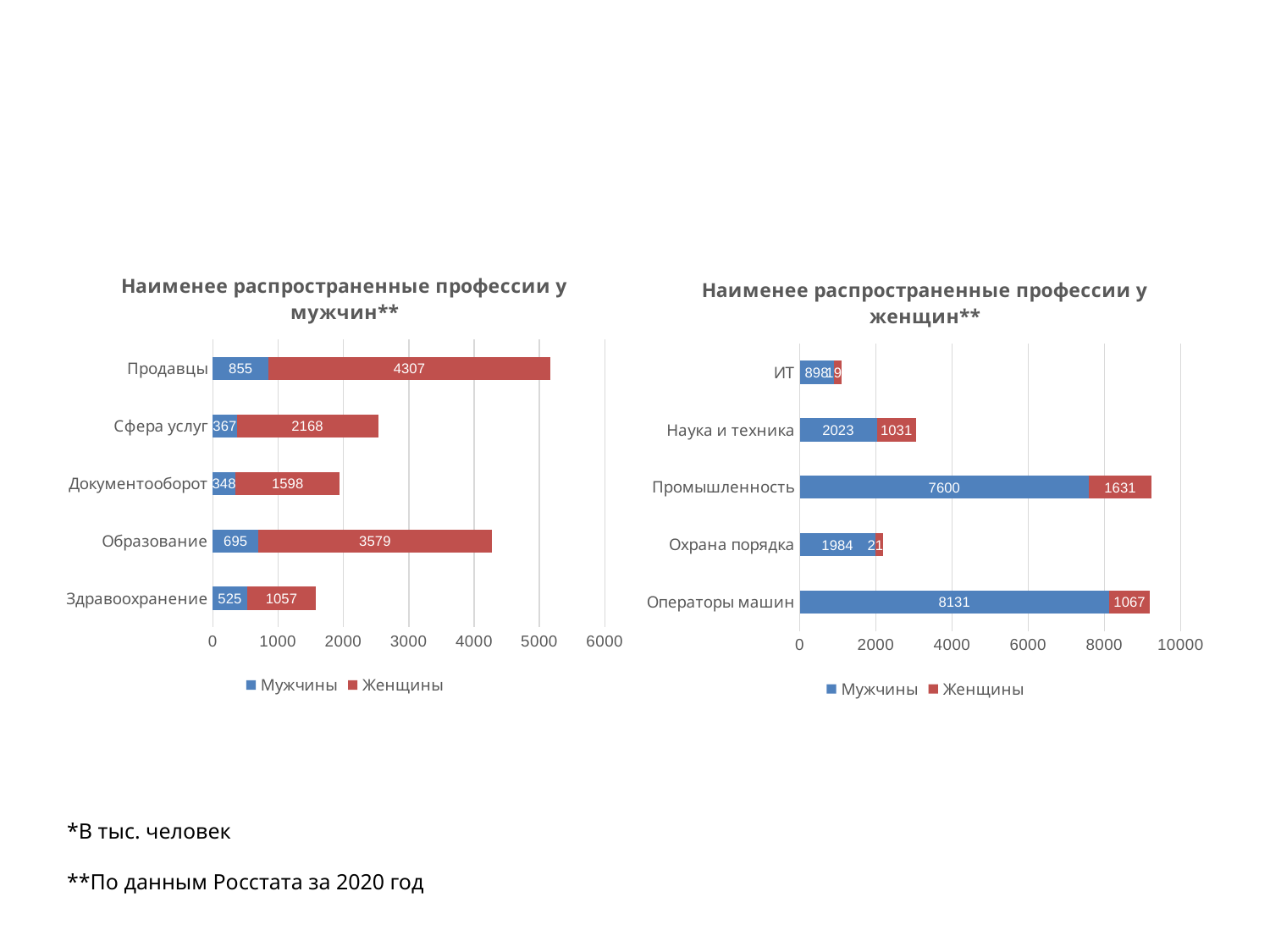
How many series does the legend of the chart 'Наименее распространенные профессии у женщин**' list? 2 In the chart 'Наименее распространенные профессии у женщин**', what is the value for Мужчины in the Операторы машин category? 8131 In the chart 'Наименее распространенные профессии у мужчин**', what is the value for Женщины in the Продавцы category? 4307 In the chart 'Наименее распространенные профессии у мужчин**', what is the total of the stacked bar for Здравоохранение? 1582 In the chart 'Наименее распространенные профессии у мужчин**', what is the difference between the Женщины values for Продавцы and Образование? 728 In the chart 'Наименее распространенные профессии у мужчин**', how many categories are shown? 5 In the chart 'Наименее распространенные профессии у мужчин**', which category has the lowest value for Мужчины? Документооборот In the chart 'Наименее распространенные профессии у женщин**', which is larger: the Мужчины value for Наука и техника or for Охрана порядка? Наука и техника In the chart 'Наименее распространенные профессии у женщин**', what is the value for Женщины in the Промышленность category? 1631 In the chart 'Наименее распространенные профессии у женщин**', which category has the highest value for Женщины? Промышленность In the chart 'Наименее распространенные профессии у женщин**', what is the total of the stacked bar for Наука и техника? 3054 In the chart 'Наименее распространенные профессии у мужчин**', what is the value for Мужчины in the Образование category? 695